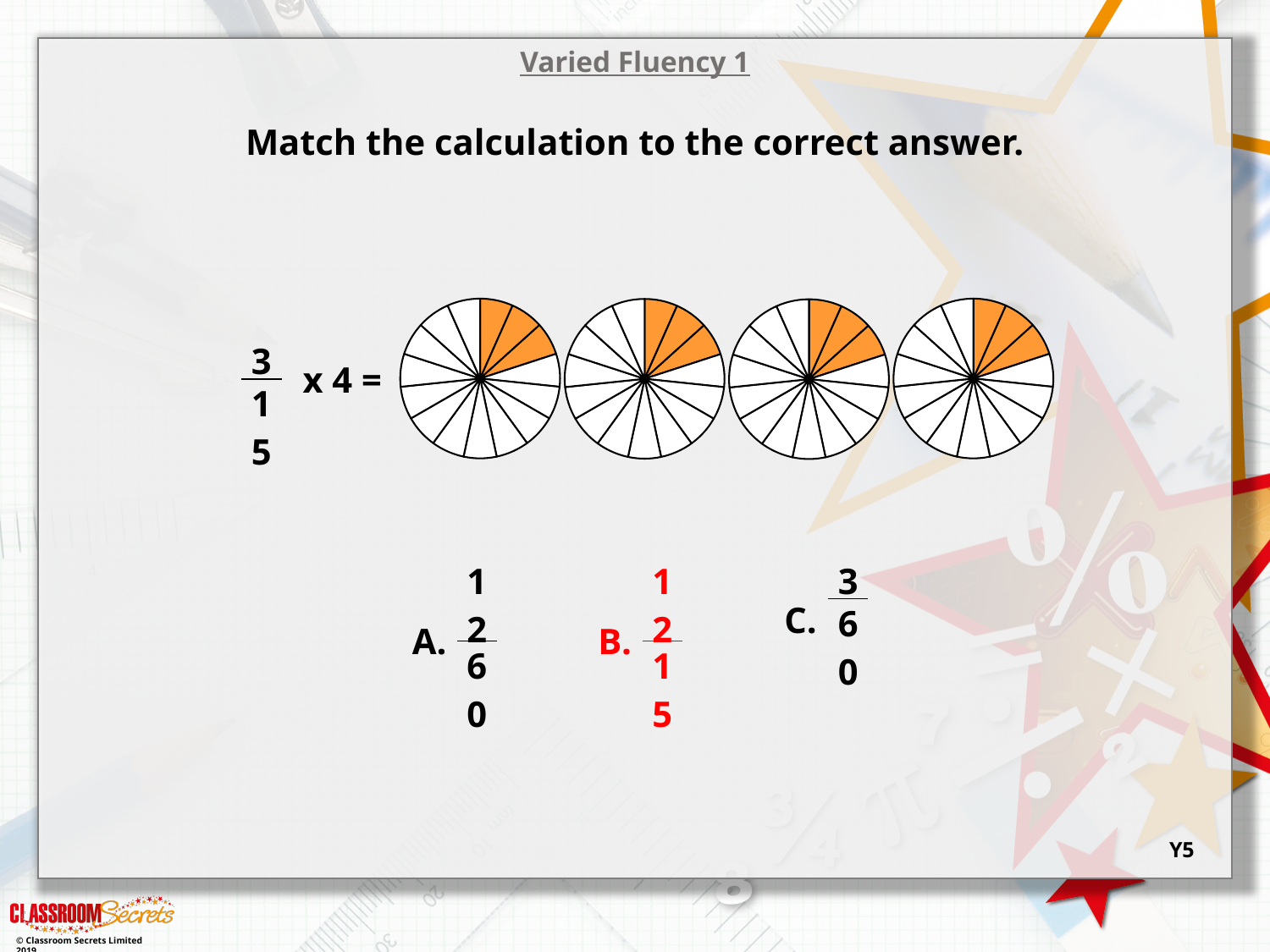
How many circle diagrams are shown next to the calculation? 4 What fraction of each circle is shaded? 3/15 How many sectors are shaded in each circle diagram? 3 Is the shaded part of each circle greater or less than half of the circle? less What colour are the shaded sectors in the circle diagrams? orange How many equal sectors is each circle divided into? 15 Which calculation do the four circle diagrams represent? 3/15 x 4 How many shaded sectors are there in total across all four circles? 12